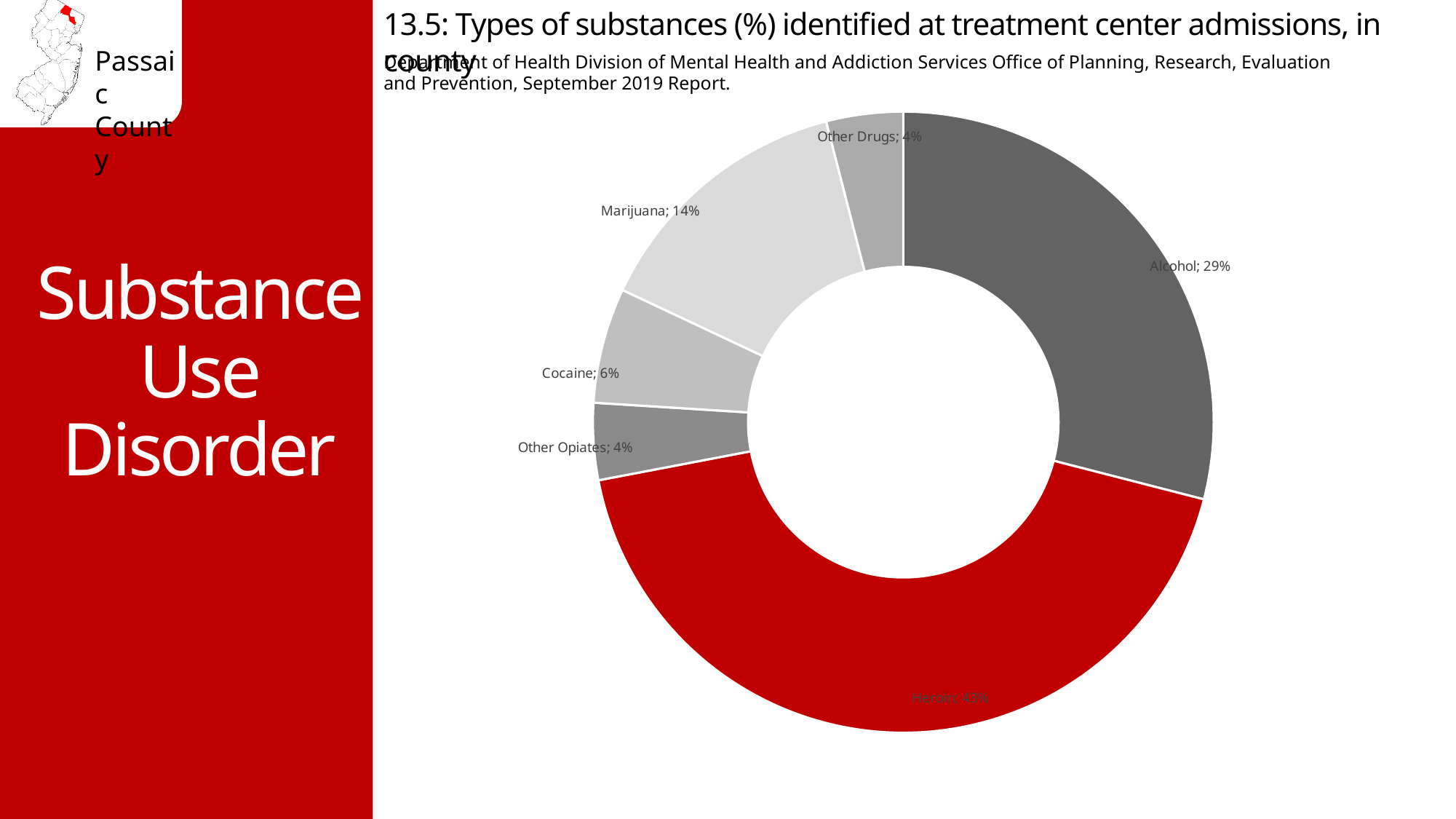
What type of chart is used on this slide? Pie chart (doughnut) Which has a larger share of admissions, Alcohol or Marijuana? Alcohol Which has a larger share of admissions, Cocaine or Other Drugs? Cocaine How many substance categories are shown in the chart? 6 What percentage of treatment center admissions is attributed to Cocaine? 6% Which substance accounts for the largest share of treatment center admissions? Heroin What is the difference in percentage points between Alcohol and Marijuana? 15 percentage points What percentage of treatment center admissions is attributed to Other Opiates? 4% What percentage of treatment center admissions is attributed to Alcohol? 29% What percentage of treatment center admissions is attributed to Heroin? 43% What percentage of treatment center admissions is attributed to Marijuana? 14% What is the combined share of Heroin and Other Opiates? 47%